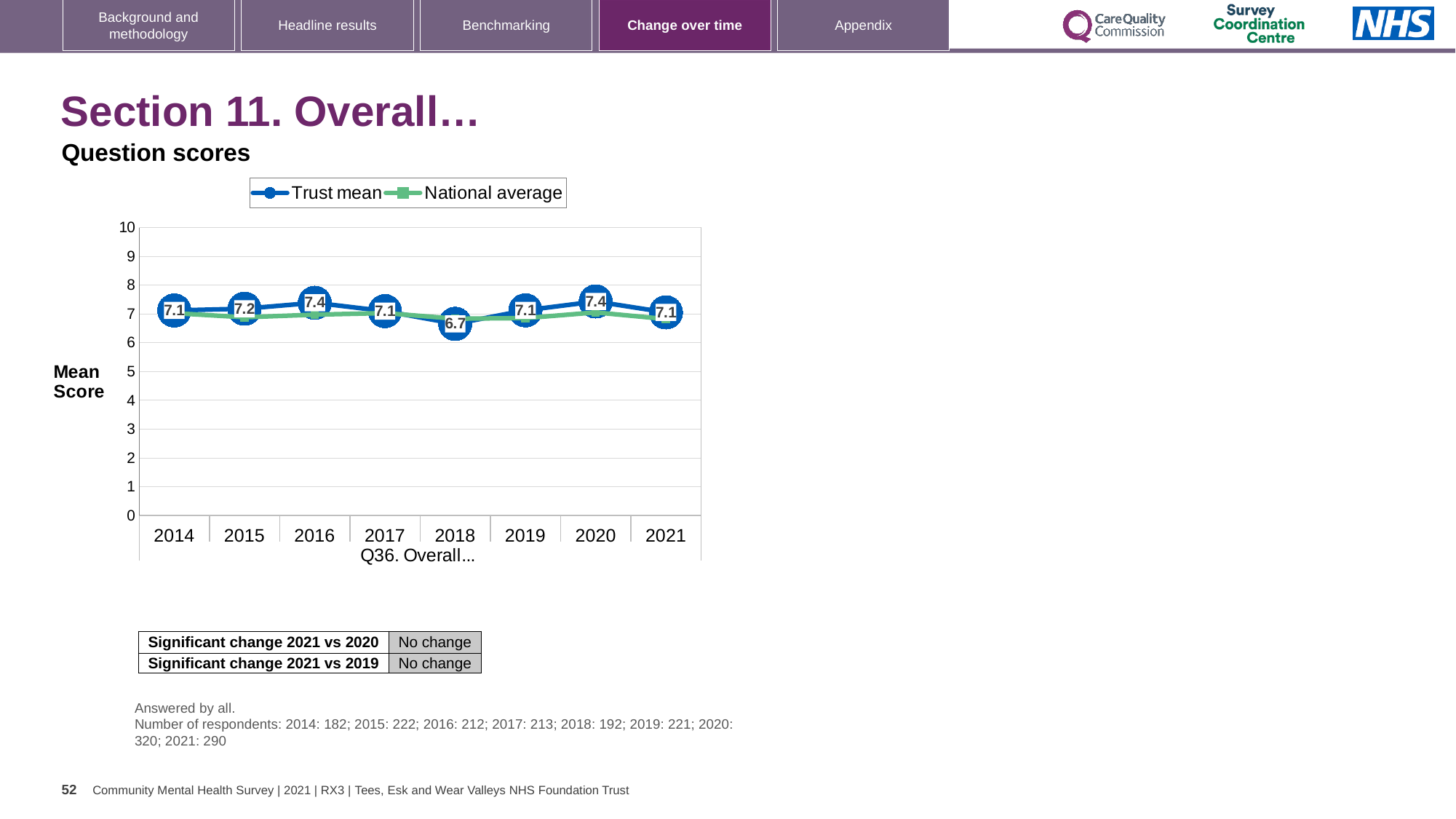
What kind of chart is shown on the slide? Line chart Is the National average for 2018 greater or less than 8? less How many years are shown on the x axis? 8 What is the Trust mean for 2018? 6.7 How many series does the legend list? 2 In which year is the Trust mean lowest? 2018 What is the Trust mean for 2015? 7.2 What is the difference between the Trust mean in 2020 and in 2021? 0.3 What is the Trust mean for 2016? 7.4 What is the highest Trust mean value shown on the chart? 7.4 Which year has the larger Trust mean, 2016 or 2018? 2016 What is the Trust mean for 2021? 7.1